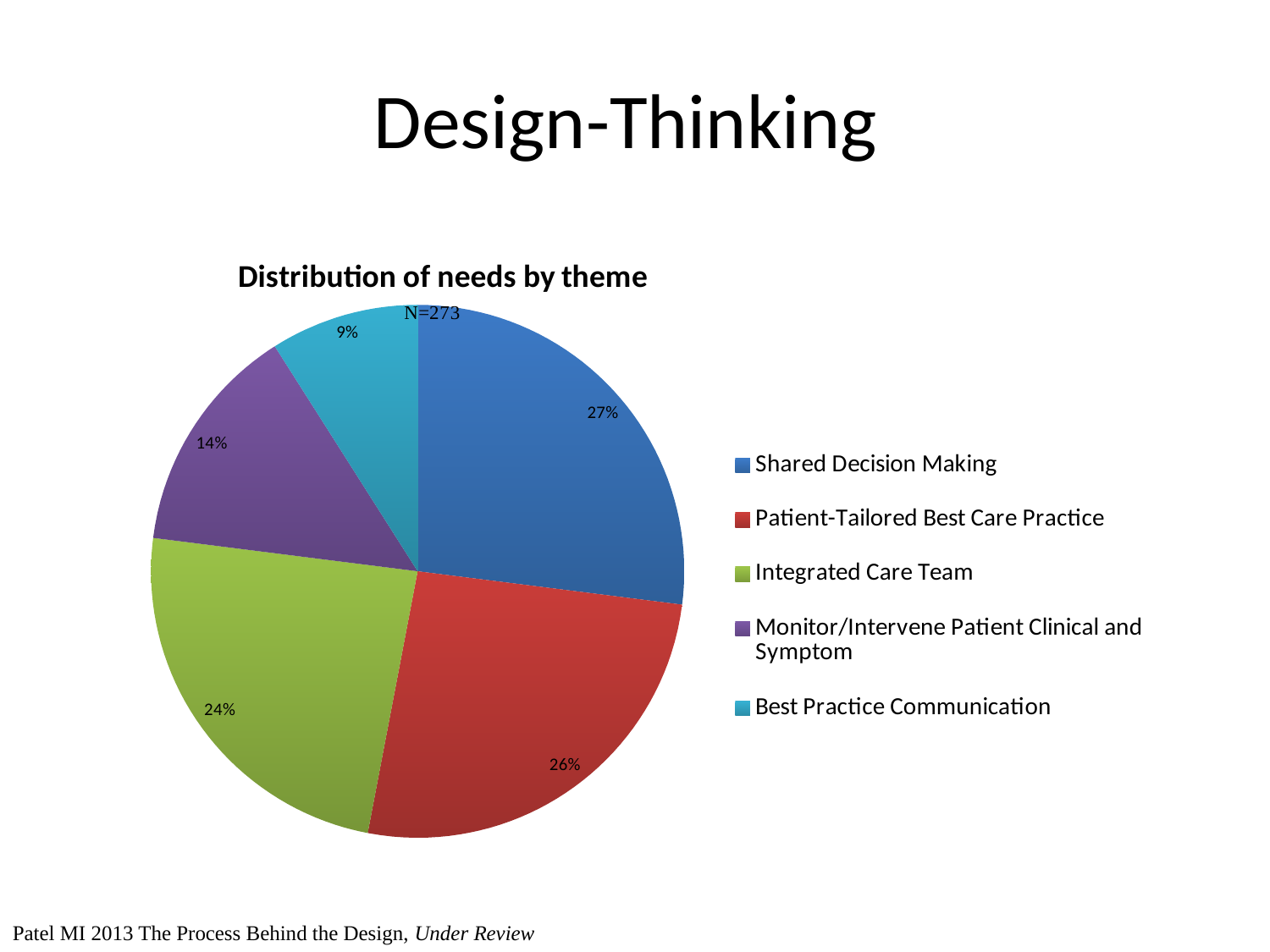
Which has a larger share: Integrated Care Team or Monitor/Intervene Patient Clinical and Symptom? Integrated Care Team What is the difference in percentage points between Integrated Care Team and Best Practice Communication? 15 Which theme has the smallest share of needs? Best Practice Communication How many themes are shown in the pie chart? 5 What percentage of needs falls under Best Practice Communication? 9% Which theme has the largest share of needs? Shared Decision Making What percentage of needs falls under Patient-Tailored Best Care Practice? 26% What type of chart is shown on the slide? pie chart What percentage of needs falls under Monitor/Intervene Patient Clinical and Symptom? 14% What percentage of needs falls under Integrated Care Team? 24% What percentage of needs falls under Shared Decision Making? 27% What is the title of the chart? Distribution of needs by theme